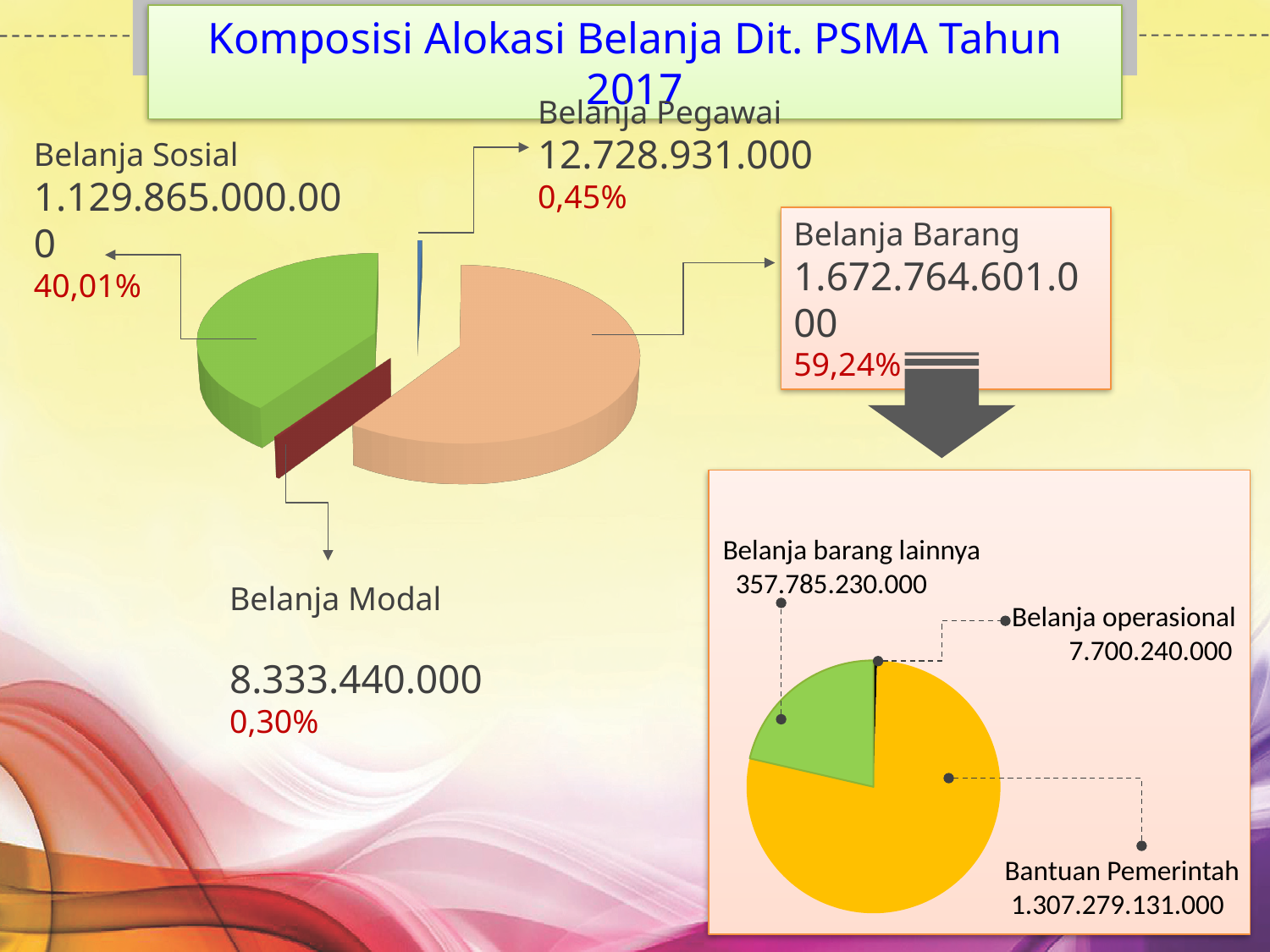
In the main pie chart, which category has the largest share? Belanja Barang In the main pie chart, which category has the smallest share? Belanja Modal In the main pie chart, what is the difference in percentage points between the shares of Belanja Barang and Belanja Sosial? 19,23% In the main pie chart, what is the value for Belanja Pegawai? 12.728.931.000 In the main pie chart, how many categories are shown? 4 In the main pie chart, what is the value for Belanja Modal? 8.333.440.000 In the main pie chart, what is the value for Belanja Sosial? 1.129.865.000.000 In the main pie chart, what share of the total does Belanja Barang represent? 59,24% What kind of chart is the main chart on the left of the slide? pie chart In the main pie chart, what share of the total does Belanja Modal represent? 0,30% In the smaller pie chart at the bottom right, what is the value for Bantuan Pemerintah? 1.307.279.131.000 In the main pie chart, what is the value for Belanja Barang? 1.672.764.601.000